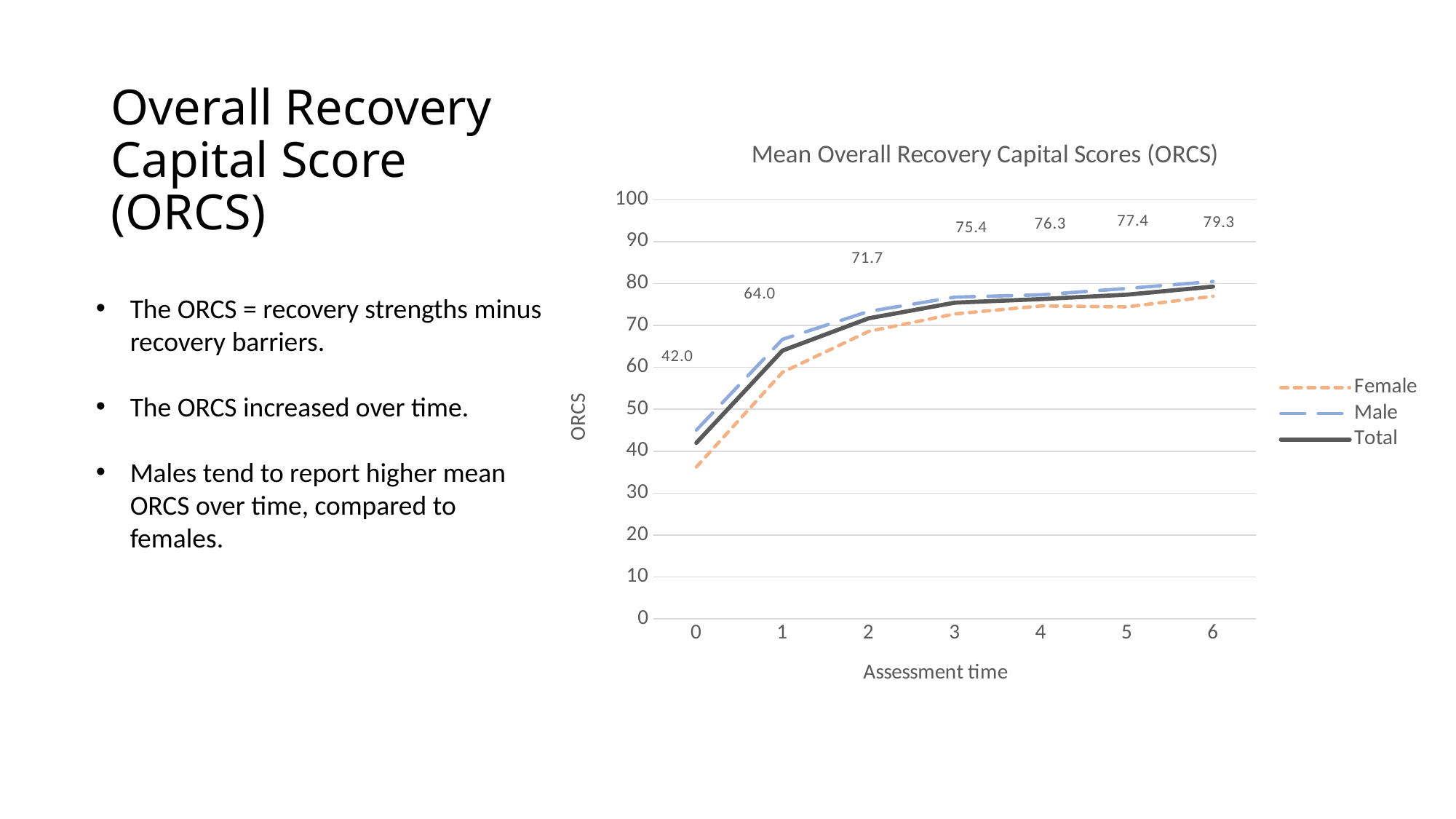
What is the Total ORCS value at assessment time 6? 79.3 What is the Total ORCS value at assessment time 0? 42.0 What is the title of the chart? Mean Overall Recovery Capital Scores (ORCS) How many series does the legend list? 3 At which assessment time is the Total ORCS value lowest? 0 What type of chart is shown on the slide? line chart What is the Total ORCS value at assessment time 1? 64.0 How many assessment time points are plotted on the x axis? 7 At which assessment time is the Total ORCS value highest? 6 Is the Female value at assessment time 0 greater or less than 40? less Does the Total ORCS value rise or fall as assessment time increases? rise What is the difference between the Total ORCS values at assessment time 6 and assessment time 0? 37.3